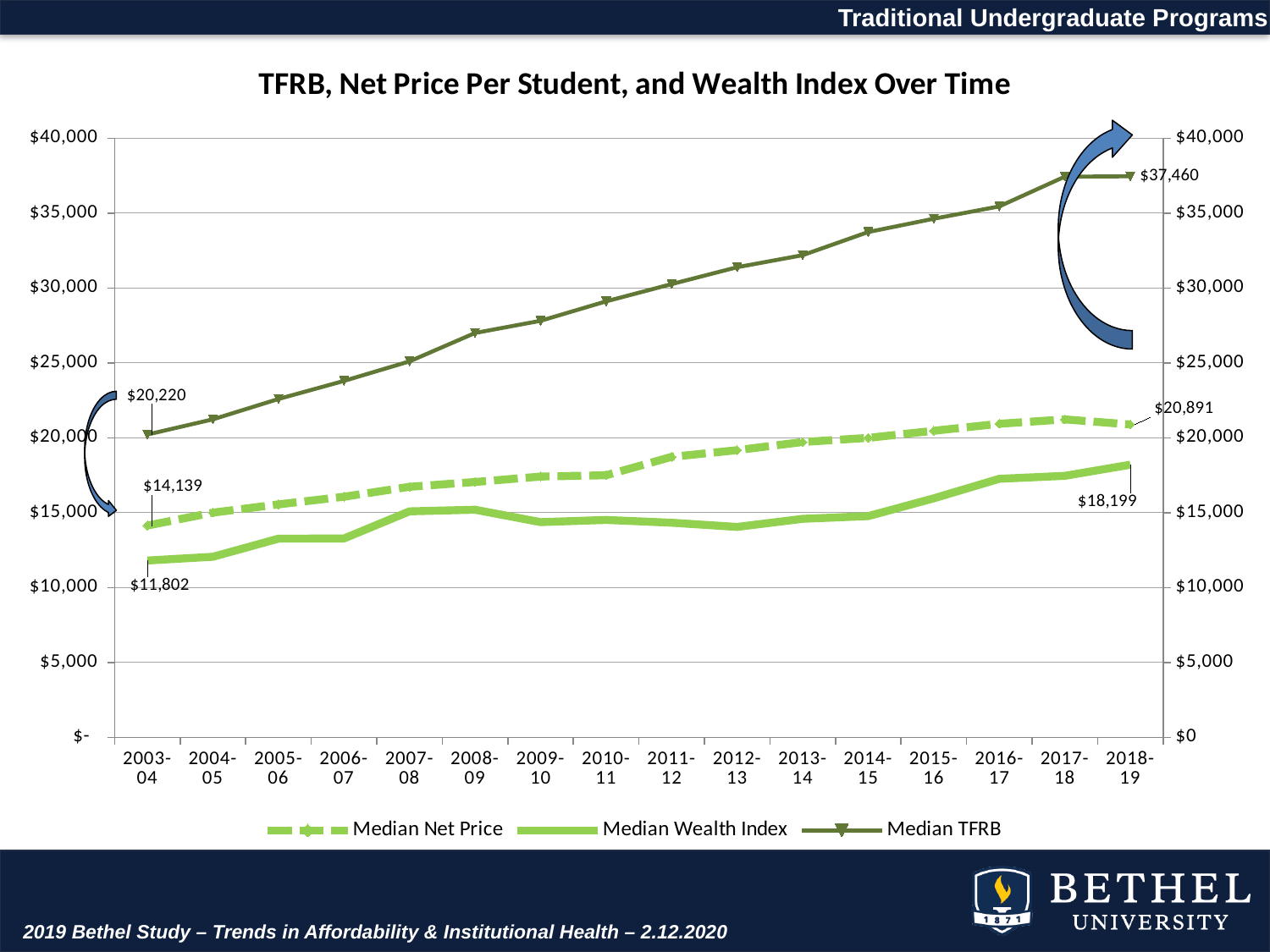
By how much did the Median TFRB increase from 2003-04 to 2018-19? $17,240 What kind of chart is shown on the slide? line chart Is the Median TFRB for 2010-11 greater or less than $25,000? greater What is the Median TFRB value for 2003-04? $20,220 By how much did the Median Wealth Index increase from 2003-04 to 2018-19? $6,397 What is the Median Net Price for 2003-04? $14,139 What is the Median TFRB value for 2018-19? $37,460 How many series does the legend list? 3 What is the Median Wealth Index for 2018-19? $18,199 Does the Median TFRB rise or fall over the years shown? rise How many academic years are shown on the x axis? 16 What is the title of the chart? TFRB, Net Price Per Student, and Wealth Index Over Time